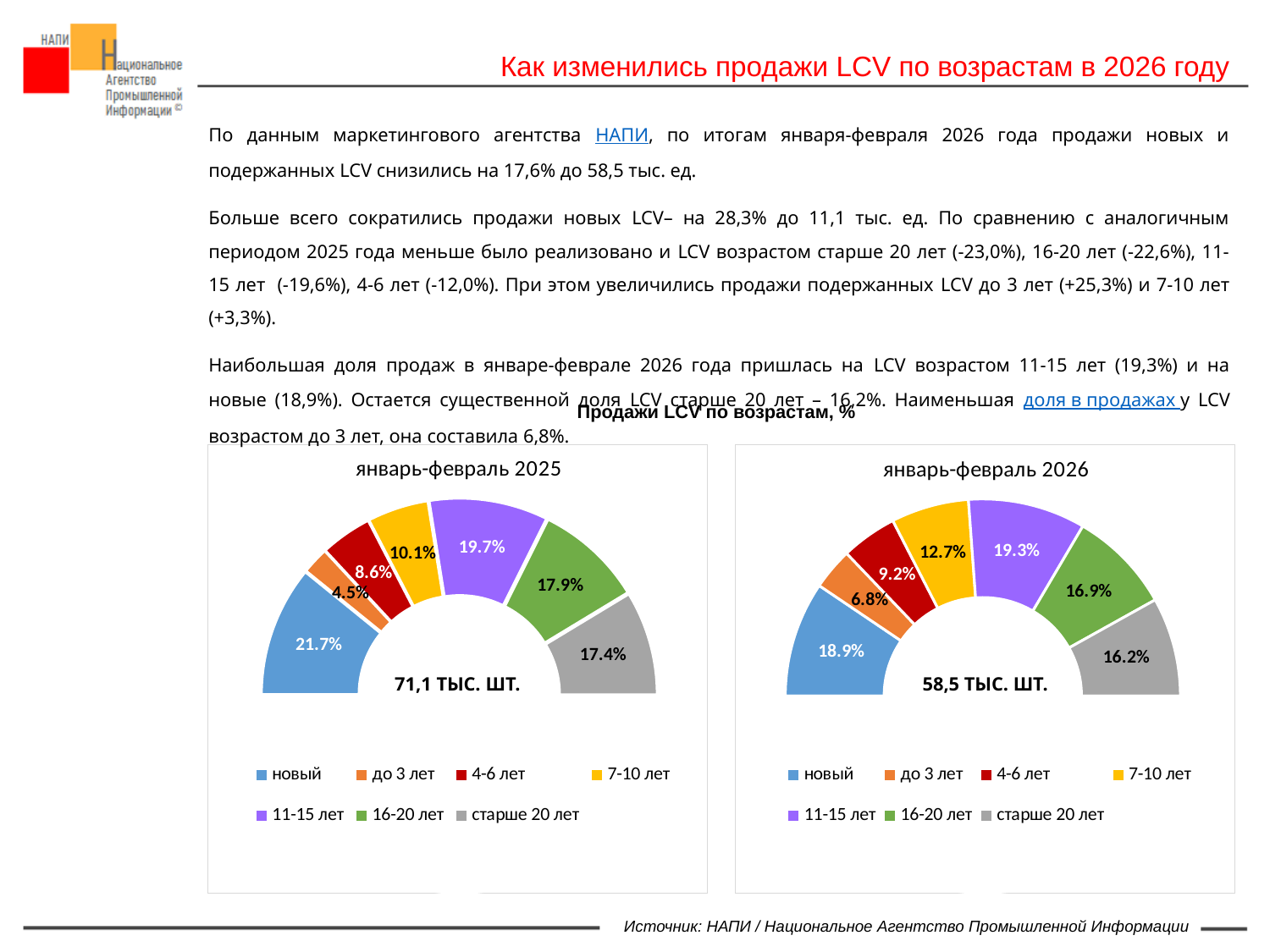
In the 'январь-февраль 2026' chart, what is the share for 'до 3 лет'? 6.8% What total value is printed in the centre of the 'январь-февраль 2026' chart? 58,5 ТЫС. ШТ. How many categories does the legend of the 'январь-февраль 2025' chart list? 7 What is the difference between the share for 'новый' in the 'январь-февраль 2025' chart and in the 'январь-февраль 2026' chart? 2.8% In the 'январь-февраль 2025' chart, which category has the smallest share? до 3 лет In the 'январь-февраль 2026' chart, what is the share for '7-10 лет'? 12.7% In the 'январь-февраль 2025' chart, which category has the largest share? новый What kind of chart is the 'январь-февраль 2026' chart? Doughnut chart In the 'январь-февраль 2026' chart, which category has the largest share? 11-15 лет In the 'январь-февраль 2026' chart, which is larger: the share for '16-20 лет' or for 'старше 20 лет'? 16-20 лет In the 'январь-февраль 2025' chart, what is the share for 'новый'? 21.7% In the 'январь-февраль 2026' chart, which category has the smallest share? до 3 лет